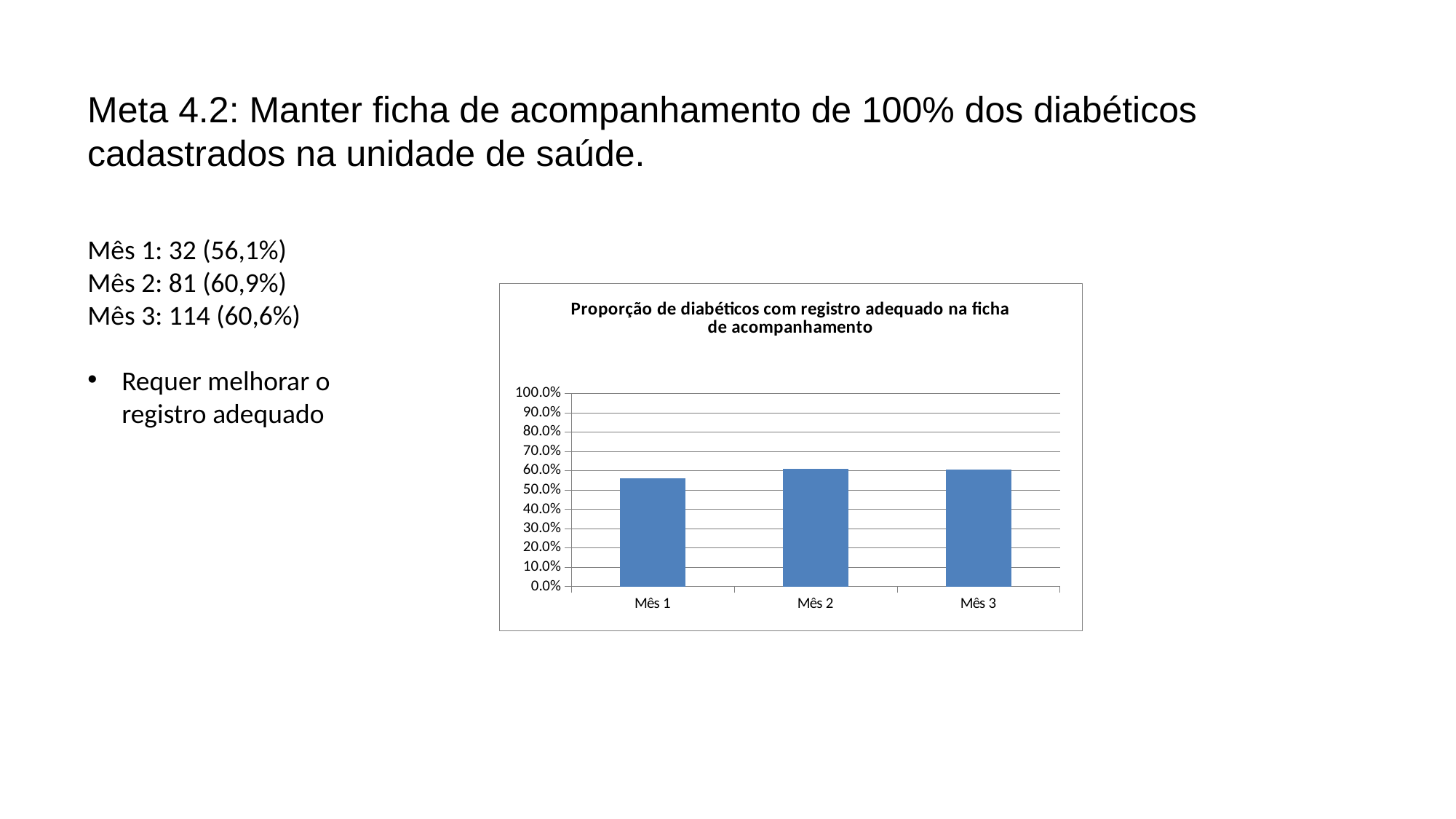
Does the value rise or fall from Mês 1 to Mês 2? rise How many categories (months) are plotted on the x axis of the chart? 3 Is the value for Mês 2 greater or less than 70.0%? less Which is larger, the value for Mês 1 or the value for Mês 2? Mês 2 Is the value for Mês 1 greater or less than 60.0%? less What kind of chart is shown on the slide? bar chart According to the slide text, what proportion is shown for Mês 1? 56,1% Is the value for Mês 3 greater or less than 50.0%? greater According to the slide text, what proportion is shown for Mês 2? 60,9% What colour are the bars in the chart? blue Which month has the lowest proportion in the chart? Mês 1 What is the title of the chart? Proporção de diabéticos com registro adequado na ficha de acompanhamento